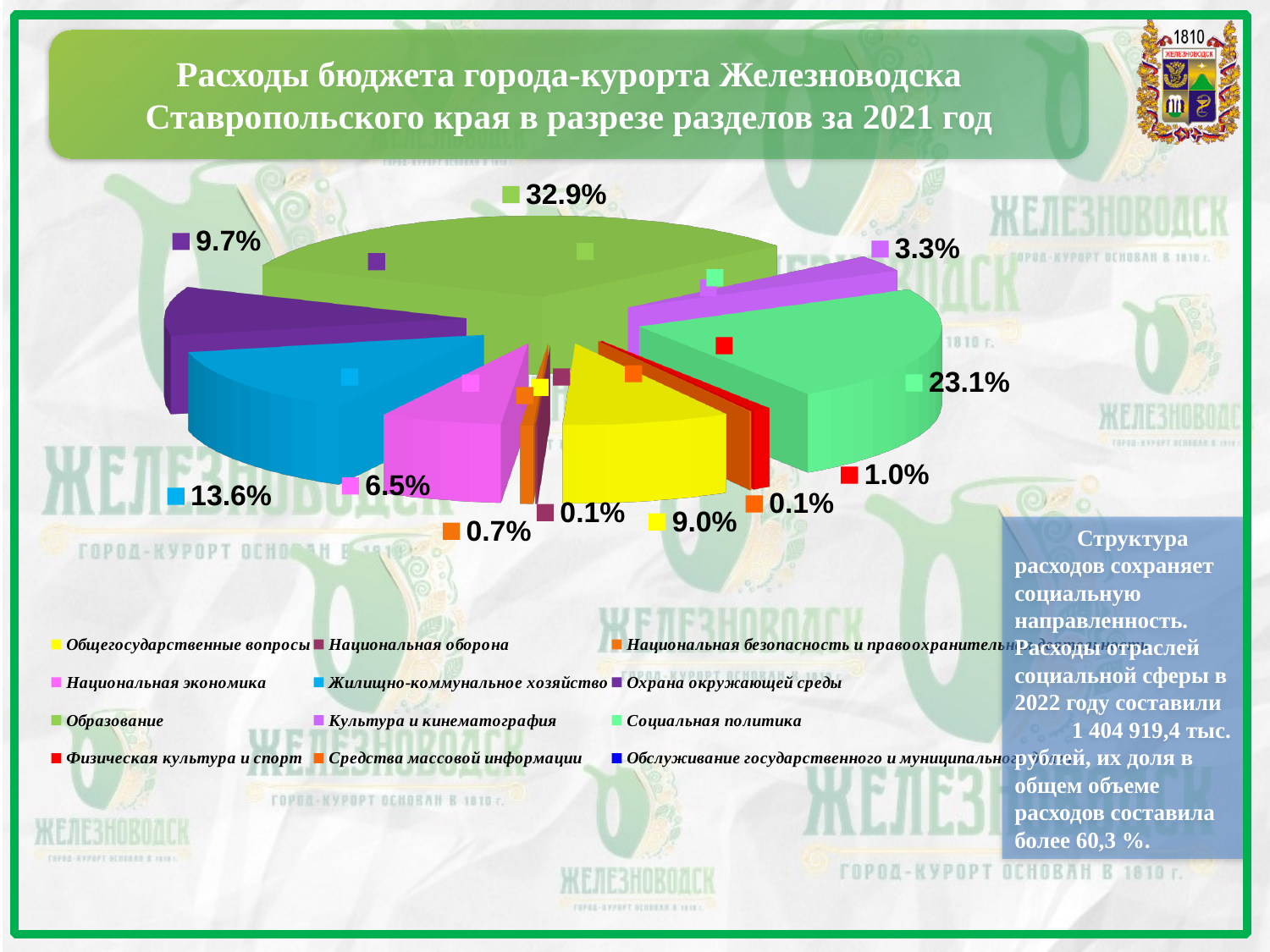
What year does the chart title say the expenditure data is for? 2021 Which section has the largest share of expenditure? Образование By how many percentage points does the share for Образование exceed the share for Социальная политика? 9.8 percentage points How many categories does the legend list? 12 What kind of chart is shown on the slide? Pie chart What percentage is labelled for Жилищно-коммунальное хозяйство? 13.6% What share of the budget expenditure goes to Образование? 32.9% What share is shown for Социальная политика? 23.1% Which is larger: the share for Социальная политика or for Жилищно-коммунальное хозяйство? Социальная политика What share is shown for Общегосударственные вопросы? 9.0% What share is shown for Физическая культура и спорт? 1.0% What percentage is labelled for Национальная экономика? 6.5%